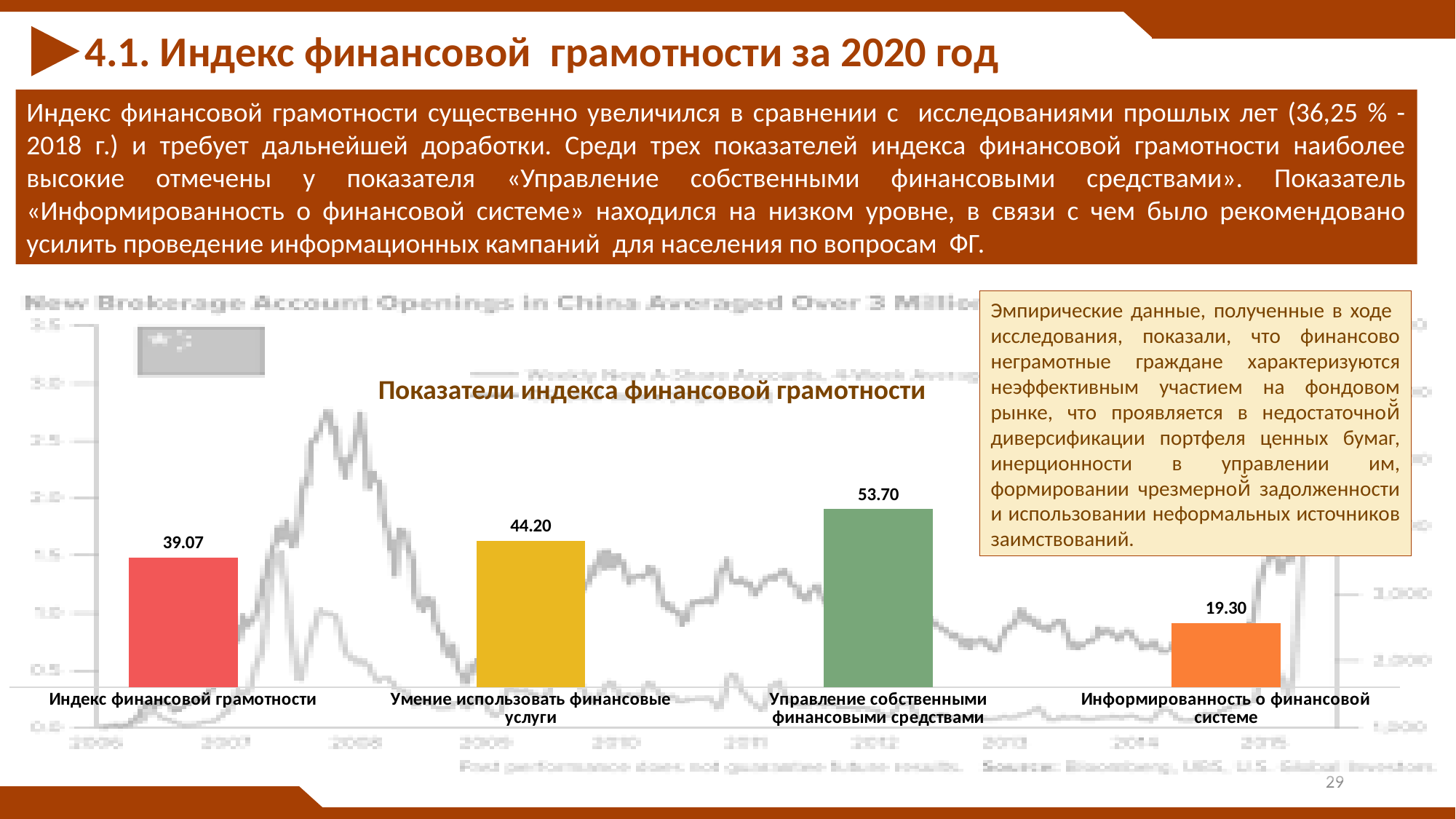
What is the value for «Индекс финансовой грамотности» in the chart «Показатели индекса финансовой грамотности»? 39.07 How many bars are shown in the chart «Показатели индекса финансовой грамотности»? 4 What is the value for «Информированность о финансовой системе»? 19.30 What is the difference between the values for «Умение использовать финансовые услуги» and «Индекс финансовой грамотности»? 5.13 What is the title of the bar chart on the slide? Показатели индекса финансовой грамотности Which category has the lowest value in the chart? Информированность о финансовой системе Which category has the highest value in the chart? Управление собственными финансовыми средствами What is the value for «Умение использовать финансовые услуги»? 44.20 What is the difference between the values for «Управление собственными финансовыми средствами» and «Информированность о финансовой системе»? 34.40 What is the value for «Управление собственными финансовыми средствами»? 53.70 Which is larger: the value for «Умение использовать финансовые услуги» or for «Индекс финансовой грамотности»? Умение использовать финансовые услуги What kind of chart is «Показатели индекса финансовой грамотности»? Bar chart